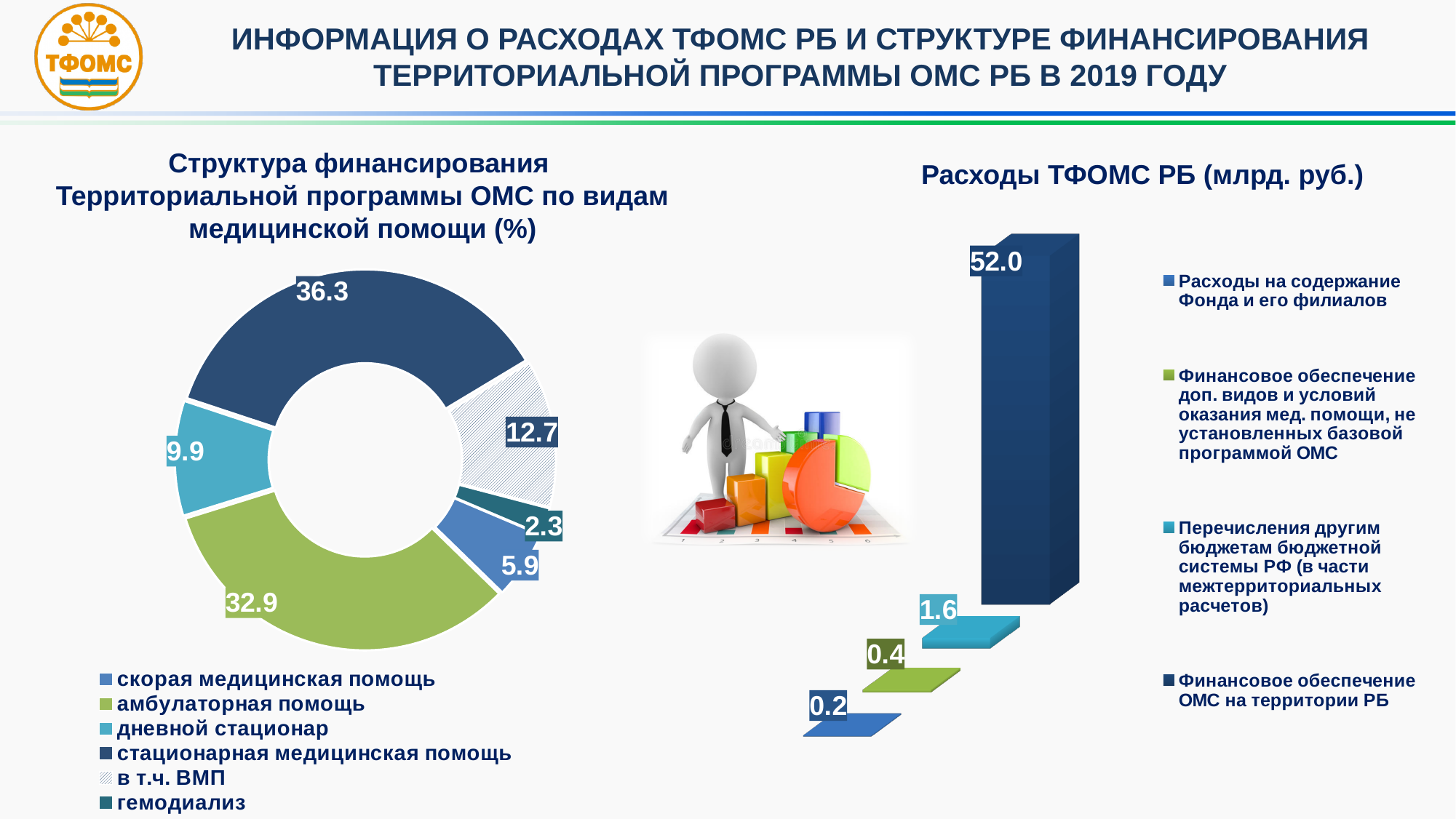
How many entries does the legend of the doughnut chart 'Структура финансирования Территориальной программы ОМС по видам медицинской помощи (%)' list? 6 On the chart 'Расходы ТФОМС РБ (млрд. руб.)', what is the value for Финансовое обеспечение ОМС на территории РБ? 52.0 On the doughnut chart 'Структура финансирования Территориальной программы ОМС по видам медицинской помощи (%)', what is the difference between стационарная медицинская помощь and амбулаторная помощь? 3.4 On the doughnut chart 'Структура финансирования Территориальной программы ОМС по видам медицинской помощи (%)', which is larger: скорая медицинская помощь or дневной стационар? дневной стационар On the doughnut chart 'Структура финансирования Территориальной программы ОМС по видам медицинской помощи (%)', which category has the largest share? стационарная медицинская помощь On the chart 'Расходы ТФОМС РБ (млрд. руб.)', what is the value for Перечисления другим бюджетам бюджетной системы РФ? 1.6 On the doughnut chart 'Структура финансирования Территориальной программы ОМС по видам медицинской помощи (%)', what is the value for дневной стационар? 9.9 What type of chart is 'Расходы ТФОМС РБ (млрд. руб.)'? bar chart On the chart 'Расходы ТФОМС РБ (млрд. руб.)', which series has the lowest value? Расходы на содержание Фонда и его филиалов On the doughnut chart 'Структура финансирования Территориальной программы ОМС по видам медицинской помощи (%)', what is the value for амбулаторная помощь? 32.9 How many series does the legend of the chart 'Расходы ТФОМС РБ (млрд. руб.)' list? 4 On the doughnut chart 'Структура финансирования Территориальной программы ОМС по видам медицинской помощи (%)', which category has the smallest share? гемодиализ